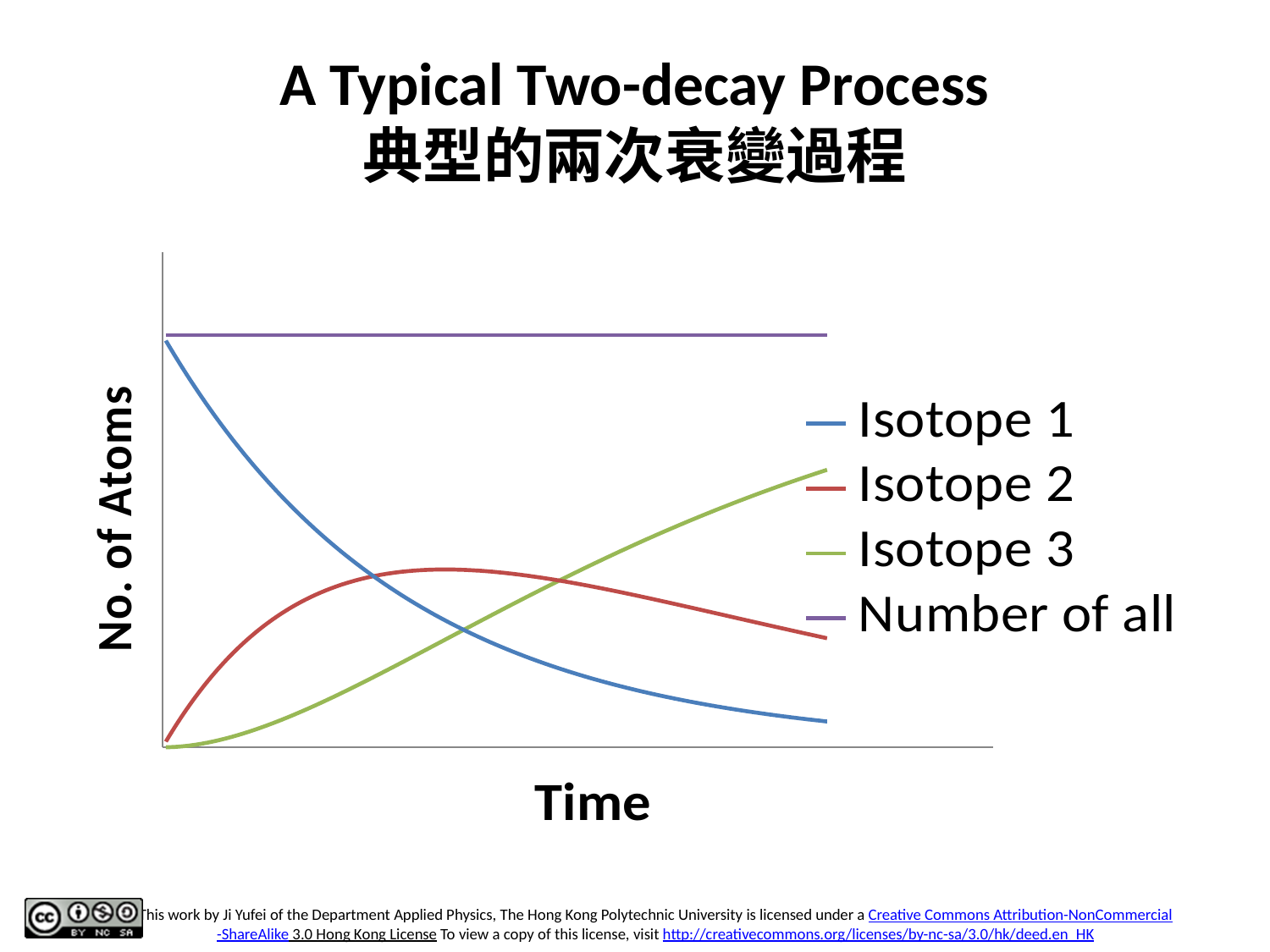
At the right end of the chart, which is larger: Isotope 3 or Isotope 2? Isotope 3 What is the label on the horizontal axis? Time Which of the three isotopes has the lowest number of atoms at the right end of the chart? Isotope 1 What is the label on the vertical axis? No. of Atoms How many series does the legend list? 4 Does the Isotope 3 line rise or fall as time increases? Rises Which series has the highest value at the right end of the chart? Number of all Which of the three isotopes has the highest number of atoms at the start (left end) of the chart? Isotope 1 Does the Isotope 1 line rise or fall as time increases? Falls Which series stays constant over time? Number of all What kind of chart is shown on the slide? Line chart